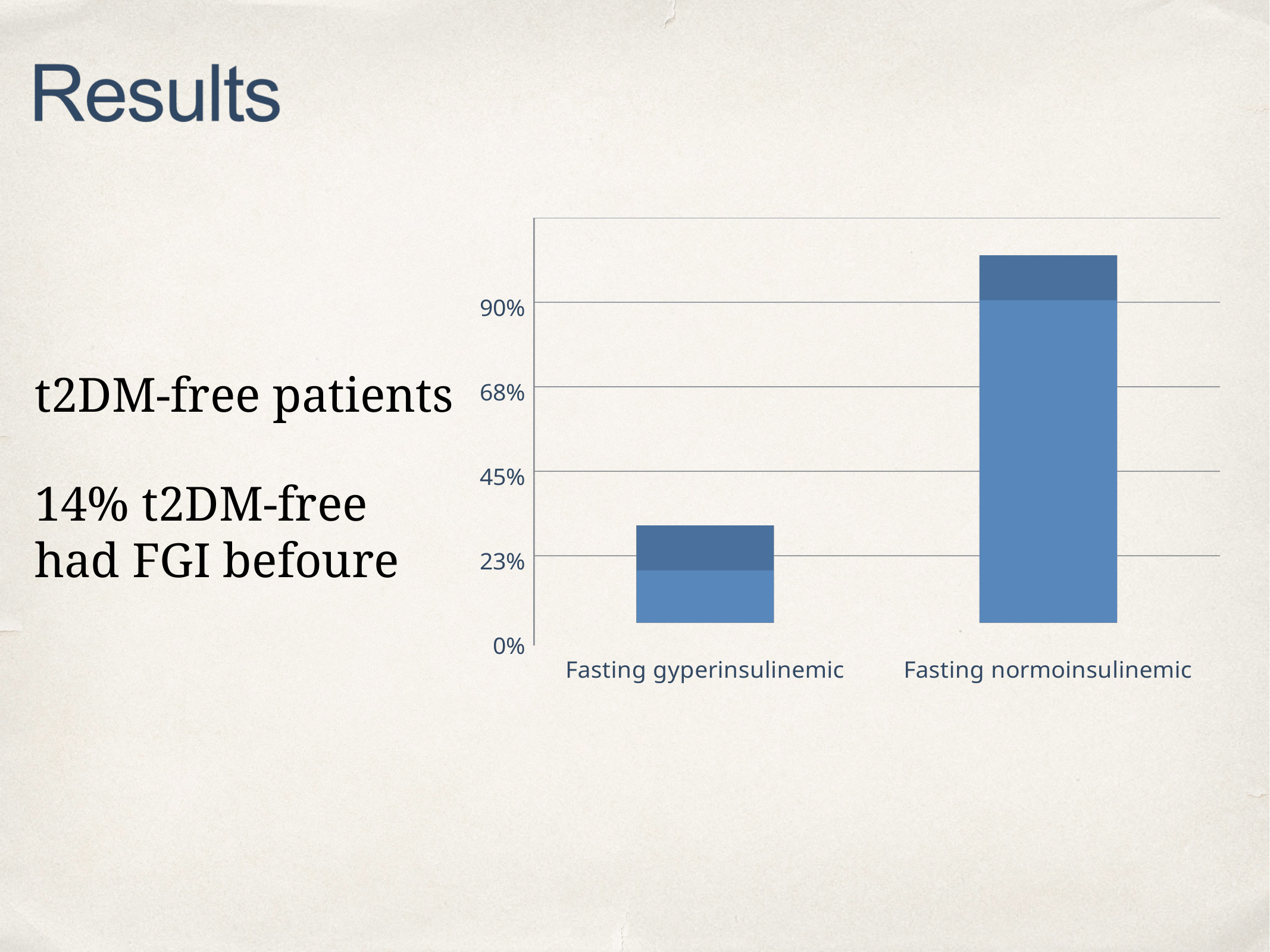
What is the label of the first category on the x axis? Fasting gyperinsulinemic Which category has the highest bar in the chart? Fasting normoinsulinemic What kind of chart is shown on the slide? bar chart Which category has the lowest bar in the chart? Fasting gyperinsulinemic Do the bar values rise or fall from left to right along the x axis? rise Is the value for Fasting gyperinsulinemic greater or less than 45%? less Which is larger, the value for Fasting gyperinsulinemic or the value for Fasting normoinsulinemic? Fasting normoinsulinemic How many categories are shown on the x axis of the chart? 2 Is the value for Fasting normoinsulinemic greater or less than 68%? greater What is the highest tick label shown on the y axis of the chart? 90%